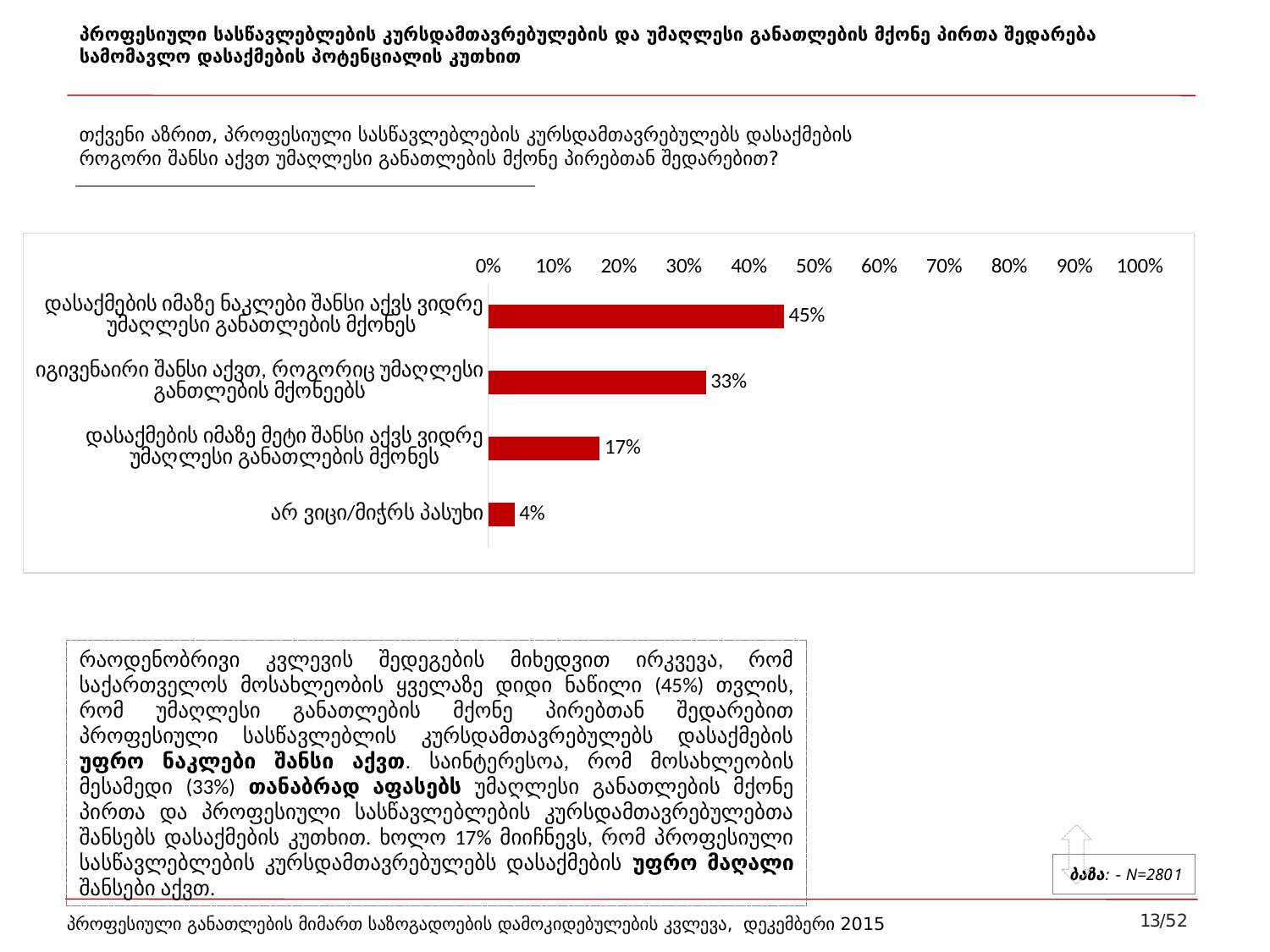
Which category has the lowest value? არ ვიცი/მიჭირს პასუხი What is the value for the category "დასაქმების იმაზე მეტი შანსი აქვს ვიდრე უმაღლესი განათლების მქონეს"? 17% What is the value for the category "დასაქმების იმაზე ნაკლები შანსი აქვს ვიდრე უმაღლესი განათლების მქონეს"? 45% What is the value for the category "არ ვიცი/მიჭირს პასუხი"? 4% What kind of chart is shown on the slide? bar chart What is the difference between the values for "დასაქმების იმაზე ნაკლები შანსი აქვს ვიდრე უმაღლესი განათლების მქონეს" and "იგივენაირი შანსი აქვთ, როგორიც უმაღლესი განათლების მქონეებს"? 12% What is the value for the category "იგივენაირი შანსი აქვთ, როგორიც უმაღლესი განათლების მქონეებს"? 33% Is the value for "დასაქმების იმაზე ნაკლები შანსი აქვს ვიდრე უმაღლესი განათლების მქონეს" greater or less than 40%? greater How many categories are shown in the chart? 4 Which category has the highest value? დასაქმების იმაზე ნაკლები შანსი აქვს ვიდრე უმაღლესი განათლების მქონეს Which is larger: the value for "დასაქმების იმაზე მეტი შანსი აქვს ვიდრე უმაღლესი განათლების მქონეს" or the value for "არ ვიცი/მიჭირს პასუხი"? დასაქმების იმაზე მეტი შანსი აქვს ვიდრე უმაღლესი განათლების მქონეს What is the difference between the values for "იგივენაირი შანსი აქვთ, როგორიც უმაღლესი განათლების მქონეებს" and "დასაქმების იმაზე მეტი შანსი აქვს ვიდრე უმაღლესი განათლების მქონეს"? 16%